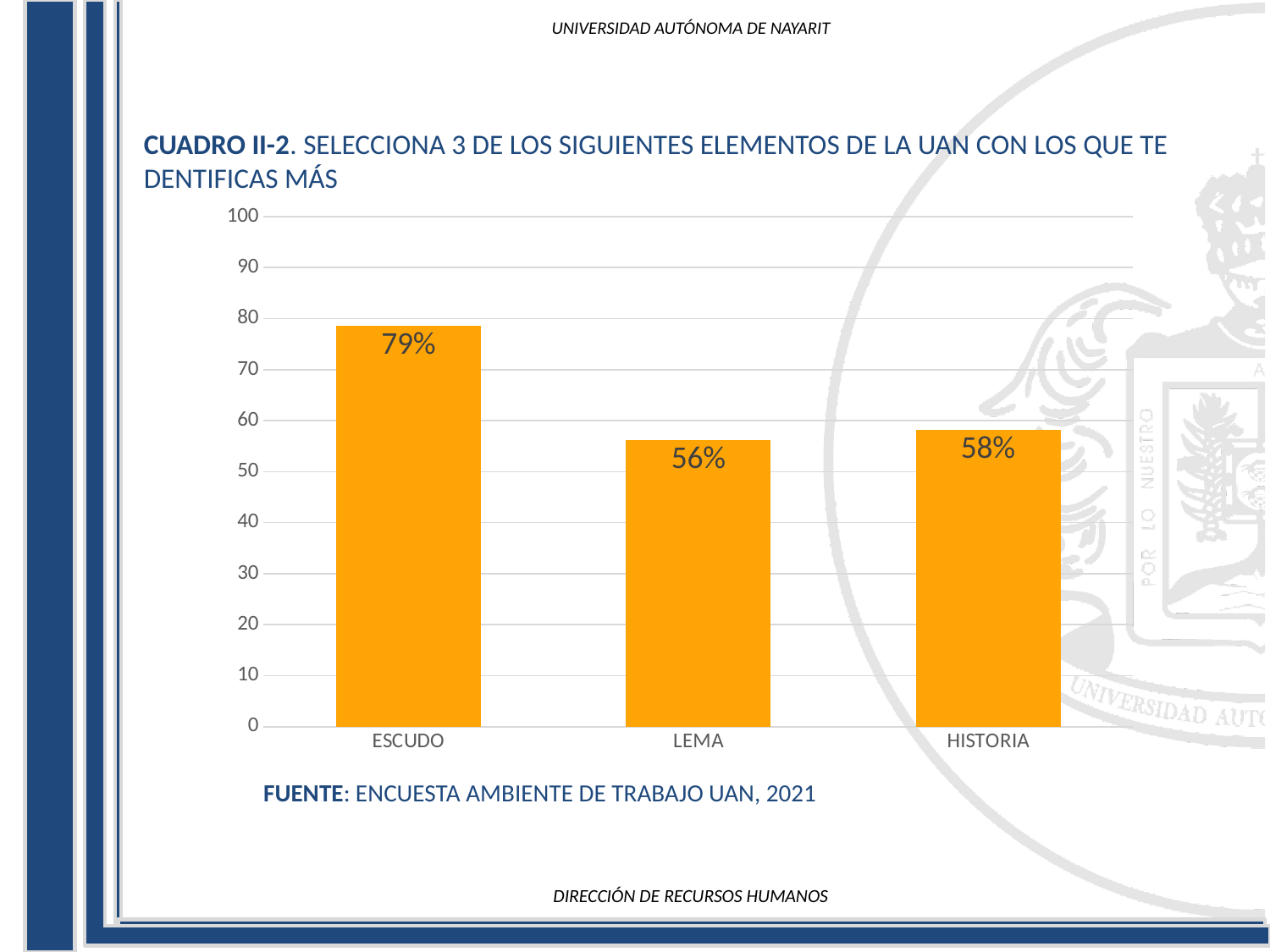
What is the value for HISTORIA? 58% What is the value for ESCUDO? 79% What kind of chart is shown on the slide? bar chart Which category has the lowest value? LEMA What is the difference between the values for HISTORIA and LEMA? 2% Which is larger, the value for ESCUDO or the value for HISTORIA? ESCUDO What source is cited below the chart? ENCUESTA AMBIENTE DE TRABAJO UAN, 2021 How many categories are shown on the x axis? 3 Which category has the highest value? ESCUDO Is the value for ESCUDO greater or less than 70? greater What is the difference between the values for ESCUDO and LEMA? 23% What is the value for LEMA? 56%